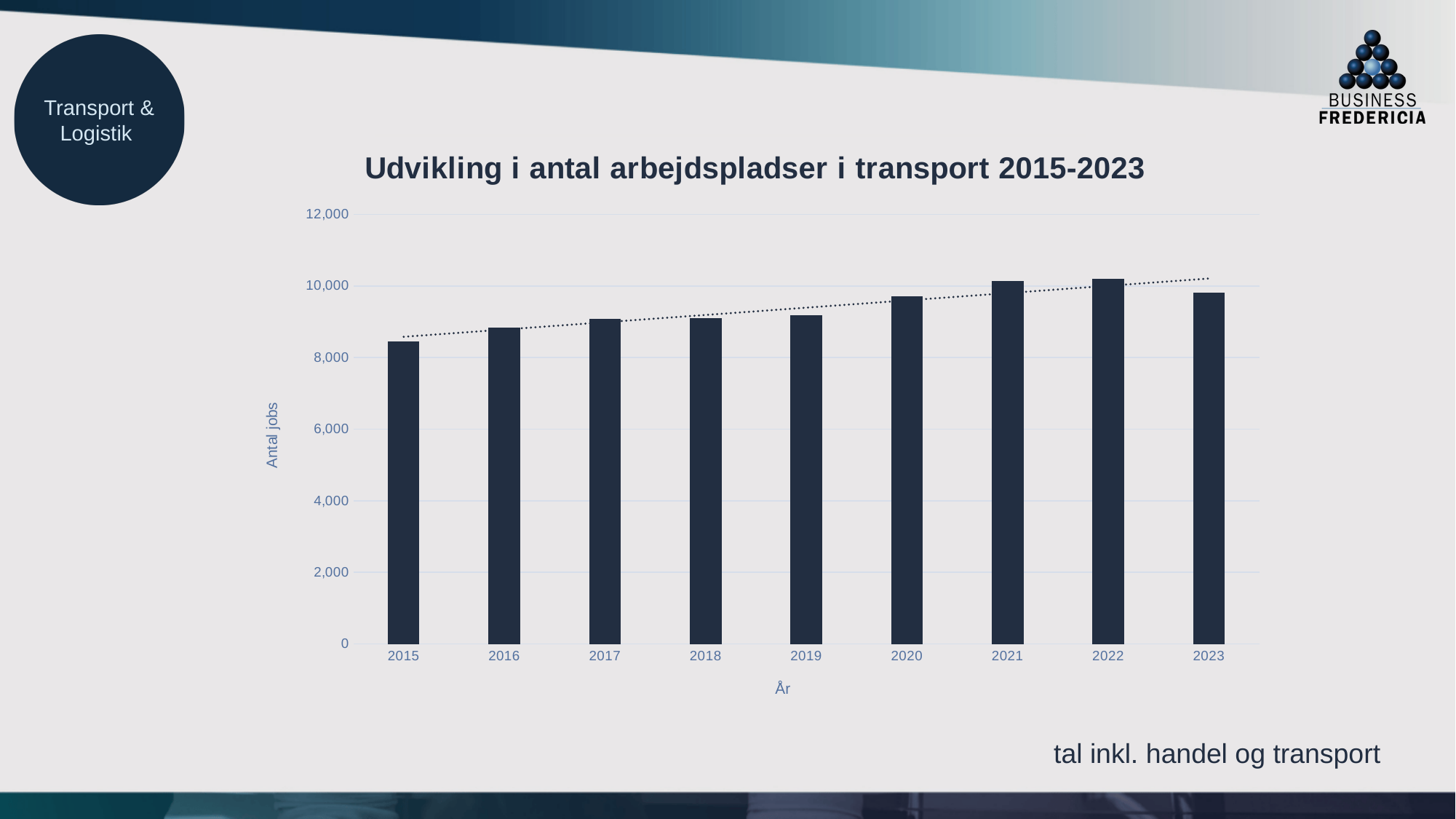
What kind of chart is shown on the slide? Bar chart Is the value for 2015 greater or less than 8,000? greater Is the value for 2020 greater or less than 10,000? less Is the value for 2021 greater or less than 10,000? greater How many years are shown on the x axis of the chart? 9 What is the label on the vertical axis of the chart? Antal jobs Which year has the lowest number of jobs in the chart? 2015 Which year has the larger value, 2015 or 2023? 2023 Do the values generally rise or fall from 2015 to 2022? rise What is the title of the chart? Udvikling i antal arbejdspladser i transport 2015-2023